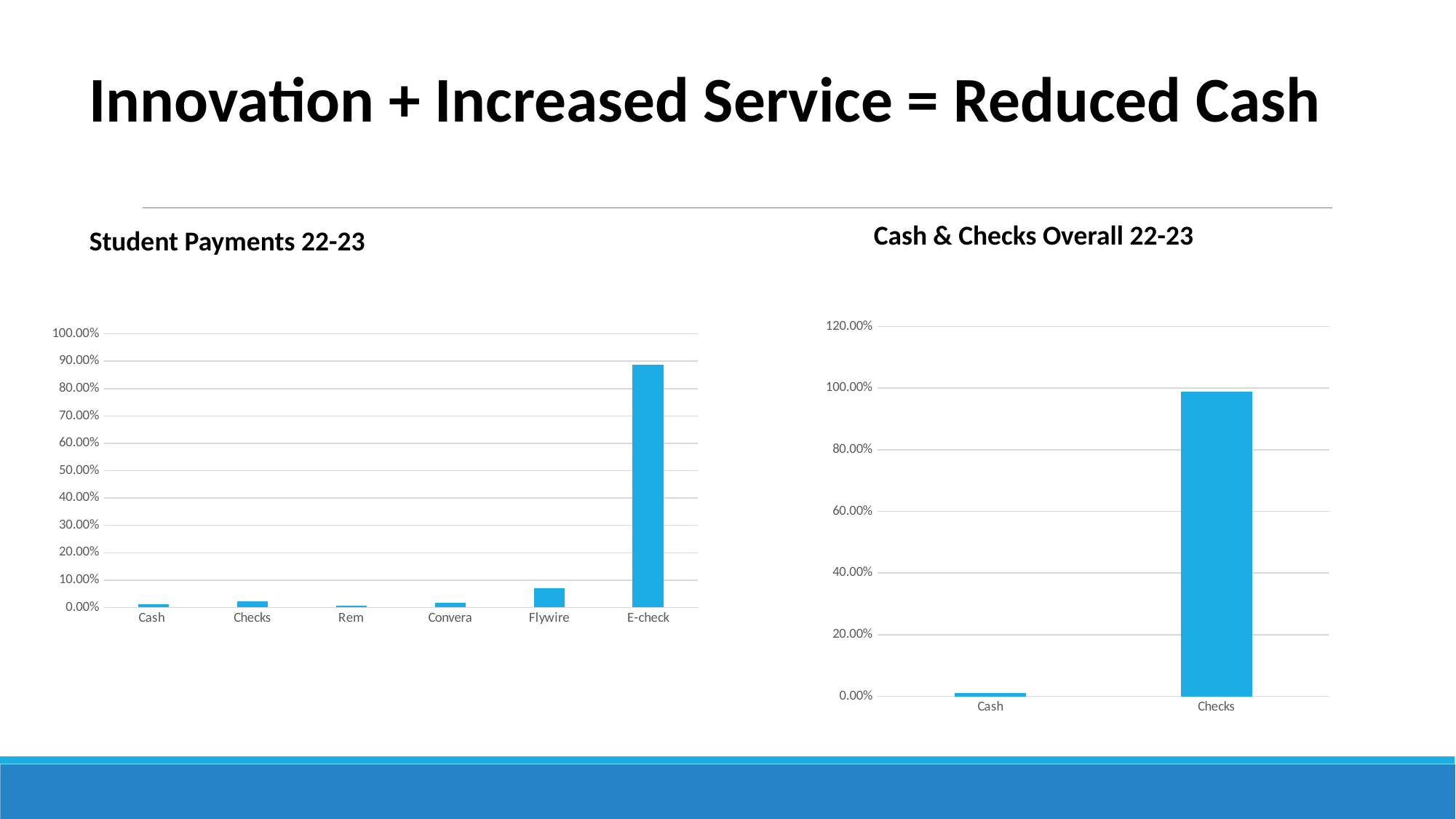
On the Cash & Checks Overall 22-23 chart, is the value for Checks greater or less than 80.00%? greater On the Student Payments 22-23 chart, which category has the highest value? E-check On the Cash & Checks Overall 22-23 chart, is the value for Cash greater or less than 20.00%? less On the Cash & Checks Overall 22-23 chart, which category has the highest value? Checks On the Student Payments 22-23 chart, is the value for Flywire greater or less than 10.00%? less What kind of chart is the Student Payments 22-23 chart? bar chart What is the title of the chart on the right side of the slide? Cash & Checks Overall 22-23 On the Student Payments 22-23 chart, which is larger, the value for Flywire or the value for E-check? E-check On the Student Payments 22-23 chart, which is larger, the value for Flywire or the value for Cash? Flywire How many categories are shown on the Cash & Checks Overall 22-23 chart? 2 How many categories are shown on the Student Payments 22-23 chart? 6